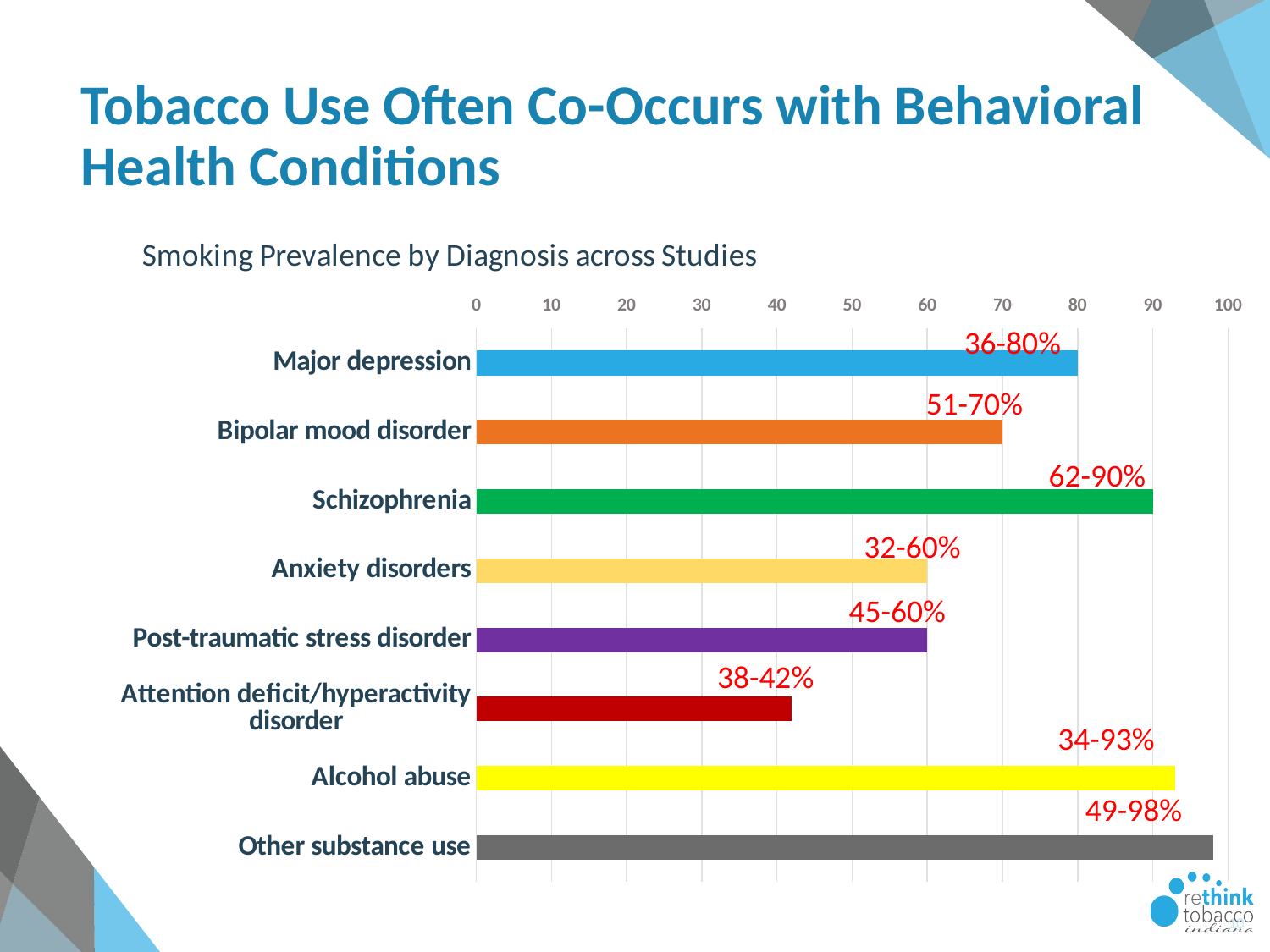
Which diagnosis has the longest bar in the chart? Other substance use What is the title of the chart? Smoking Prevalence by Diagnosis across Studies What smoking prevalence range is shown for Attention deficit/hyperactivity disorder? 38-42% What smoking prevalence range is shown for Schizophrenia? 62-90% How many diagnoses are plotted in the chart? 8 Which diagnosis has the shortest bar in the chart? Attention deficit/hyperactivity disorder What smoking prevalence range is shown for Alcohol abuse? 34-93% What smoking prevalence range is shown for Other substance use? 49-98% Which bar is longer, Schizophrenia or Bipolar mood disorder? Schizophrenia Is the end of the Alcohol abuse bar greater or less than 90? greater What kind of chart is shown on the slide? Bar chart What smoking prevalence range is shown for Major depression? 36-80%